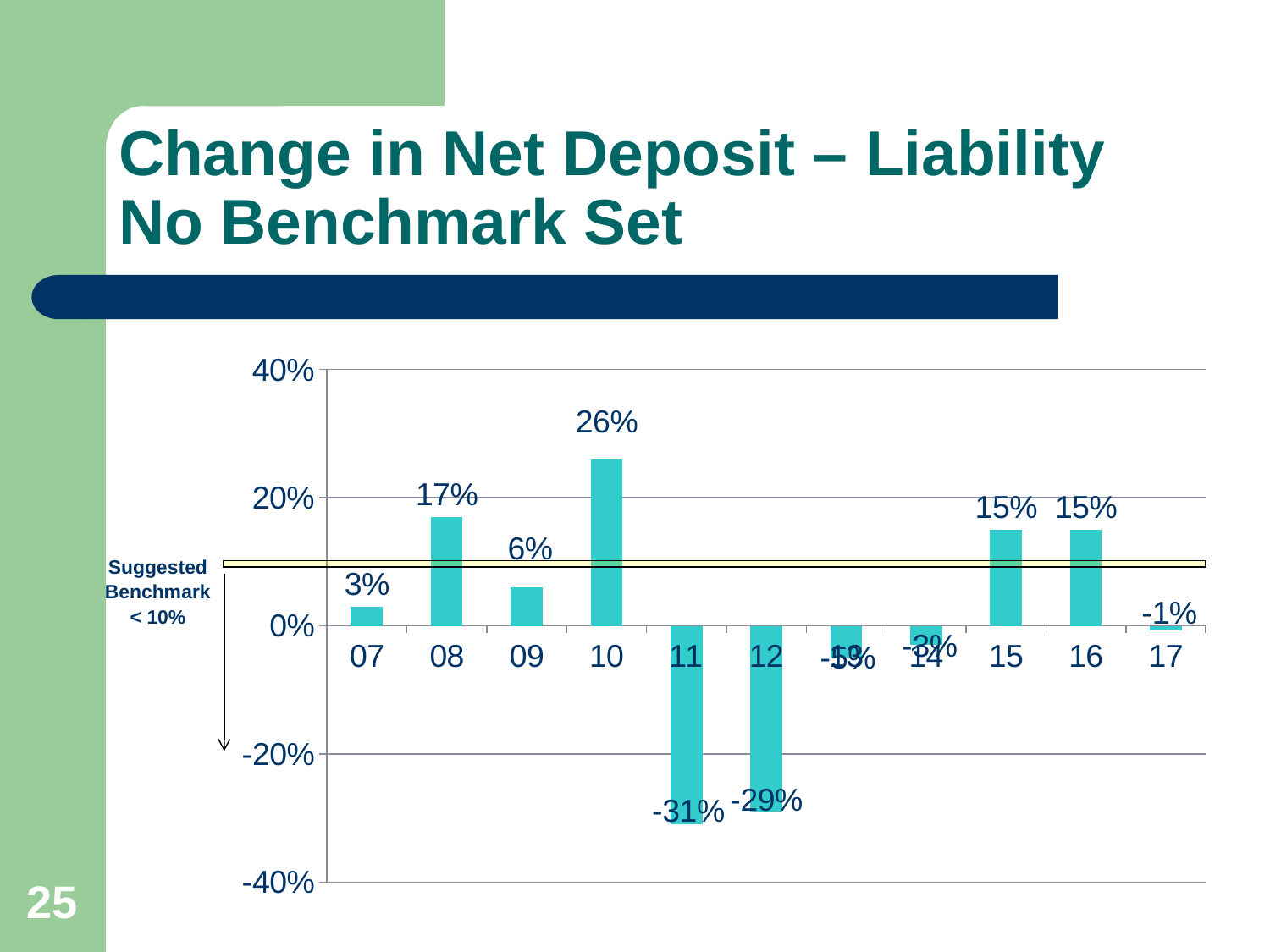
Which year has the highest value? 10 Which year has the lowest value? 11 What is the value for 11? -31% What is the value for 10? 26% What type of chart is shown on the slide? bar chart What is the value for 17? -1% How many years are shown on the x axis? 11 Which is larger, the value for 08 or the value for 09? 08 Is the value for 13 greater or less than 0%? less What is the value for 08? 17% What is the difference between the values for 10 and 08? 9% What suggested benchmark is labelled next to the horizontal line on the chart? < 10%